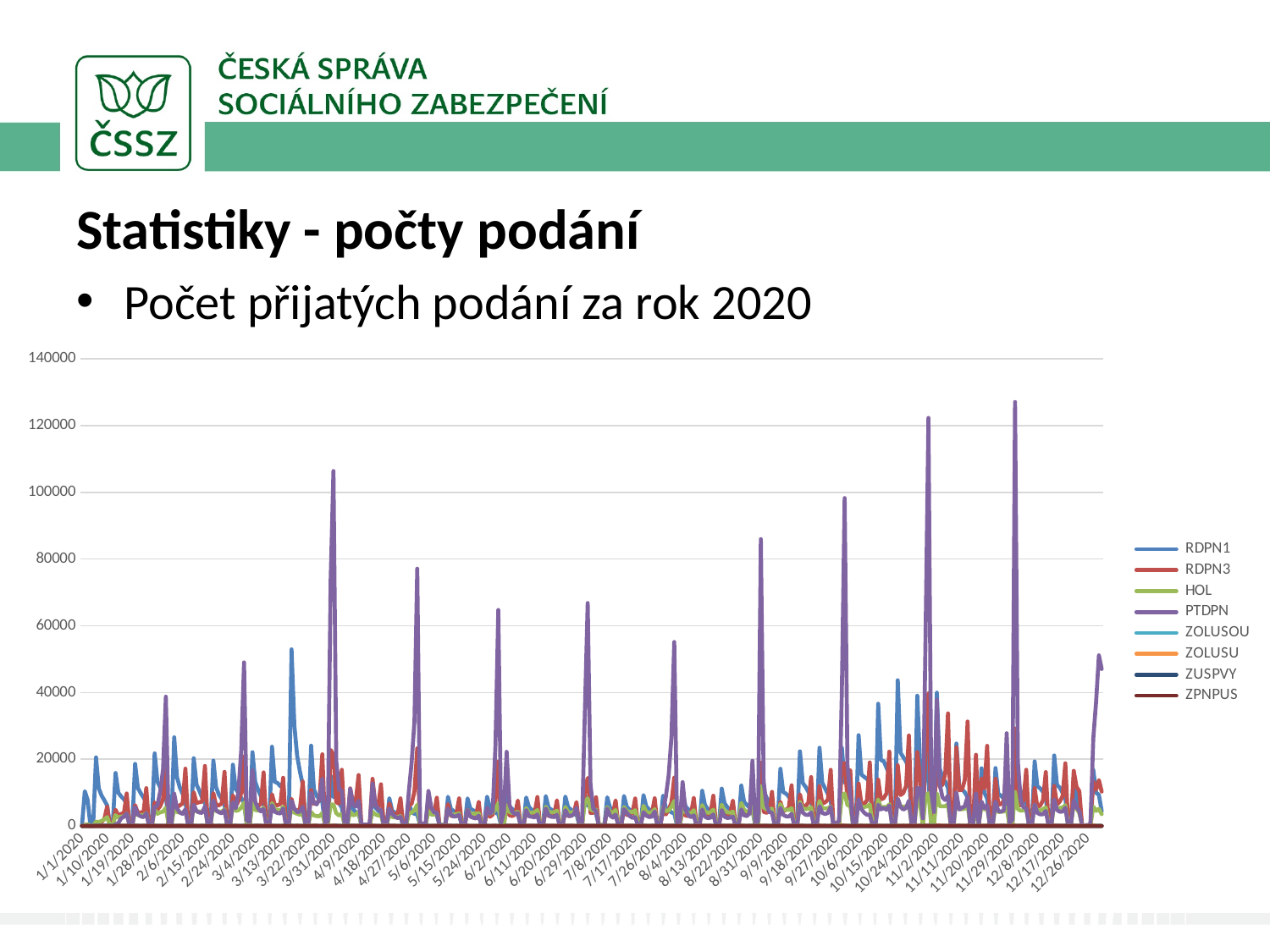
What kind of chart is shown on the slide? line chart Is the highest peak of the RDPN1 series (around 3/13/2020) greater or less than 60000? less Which series is listed first in the legend? RDPN1 Which series reaches the highest value anywhere on the chart? PTDPN Is the PTDPN peak around 3/31/2020 greater or less than 100000? greater What is the last date label on the horizontal axis? 12/26/2020 What is the highest value shown on the vertical axis? 140000 Is the highest peak of the PTDPN series (around 12/1/2020) greater or less than 120000? greater What is the first date label on the horizontal axis? 1/1/2020 How many series does the legend list? 8 Which series has the higher maximum value, PTDPN or RDPN3? PTDPN